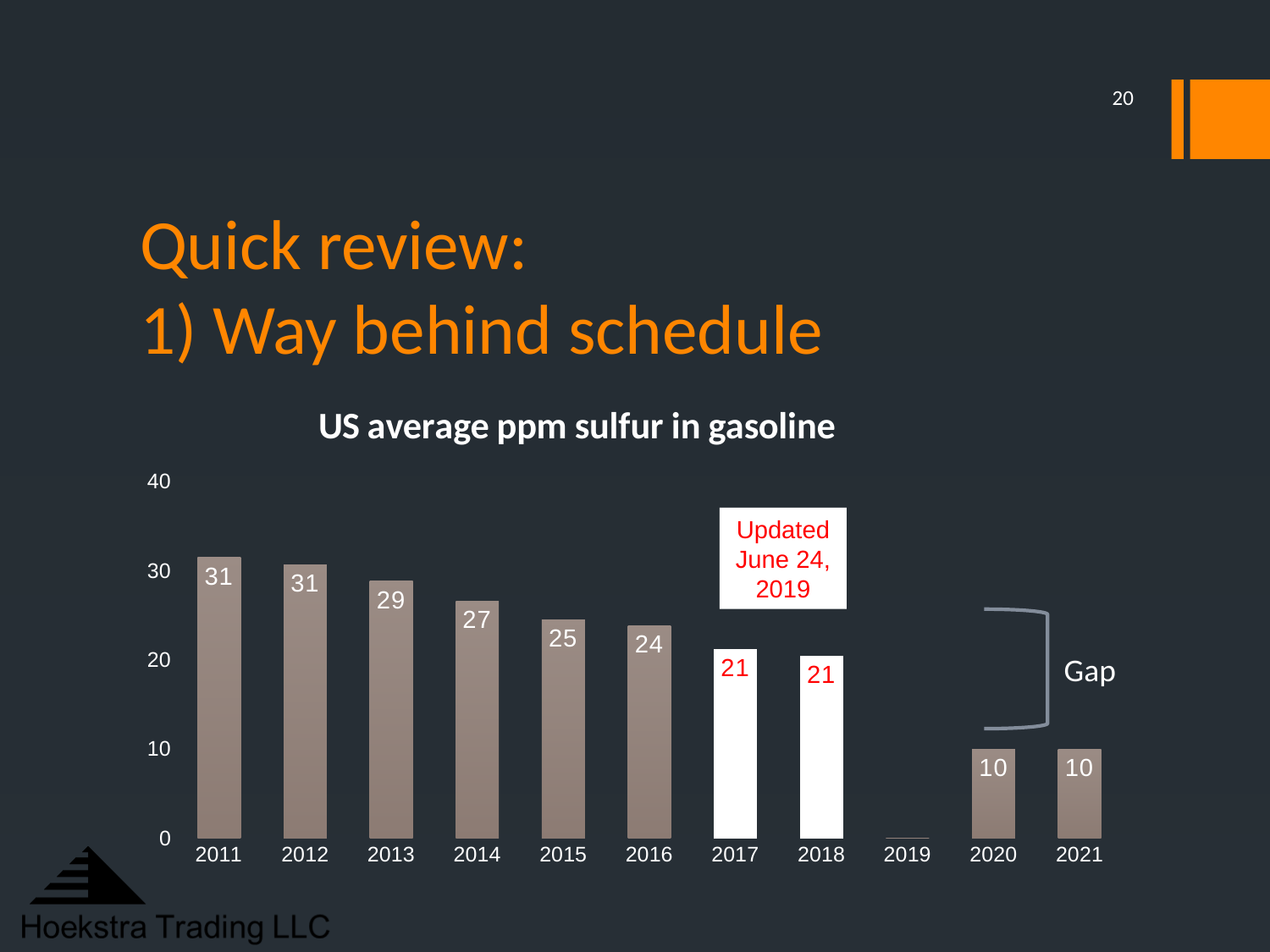
Do the values generally rise or fall from 2011 to 2021? fall What is the title of the chart? US average ppm sulfur in gasoline How many years are labeled on the x axis? 11 What kind of chart is shown on the slide? bar chart What is the value for 2018? 21 What is the difference between the values for 2011 and 2015? 6 What is the difference between the values for 2018 and 2020? 11 What is the value for 2016? 24 What is the value for 2013? 29 Which year has the lowest value among the years with a labeled bar? 2020 and 2021 What is the value for 2021? 10 Which is larger, the value for 2014 or the value for 2017? 2014